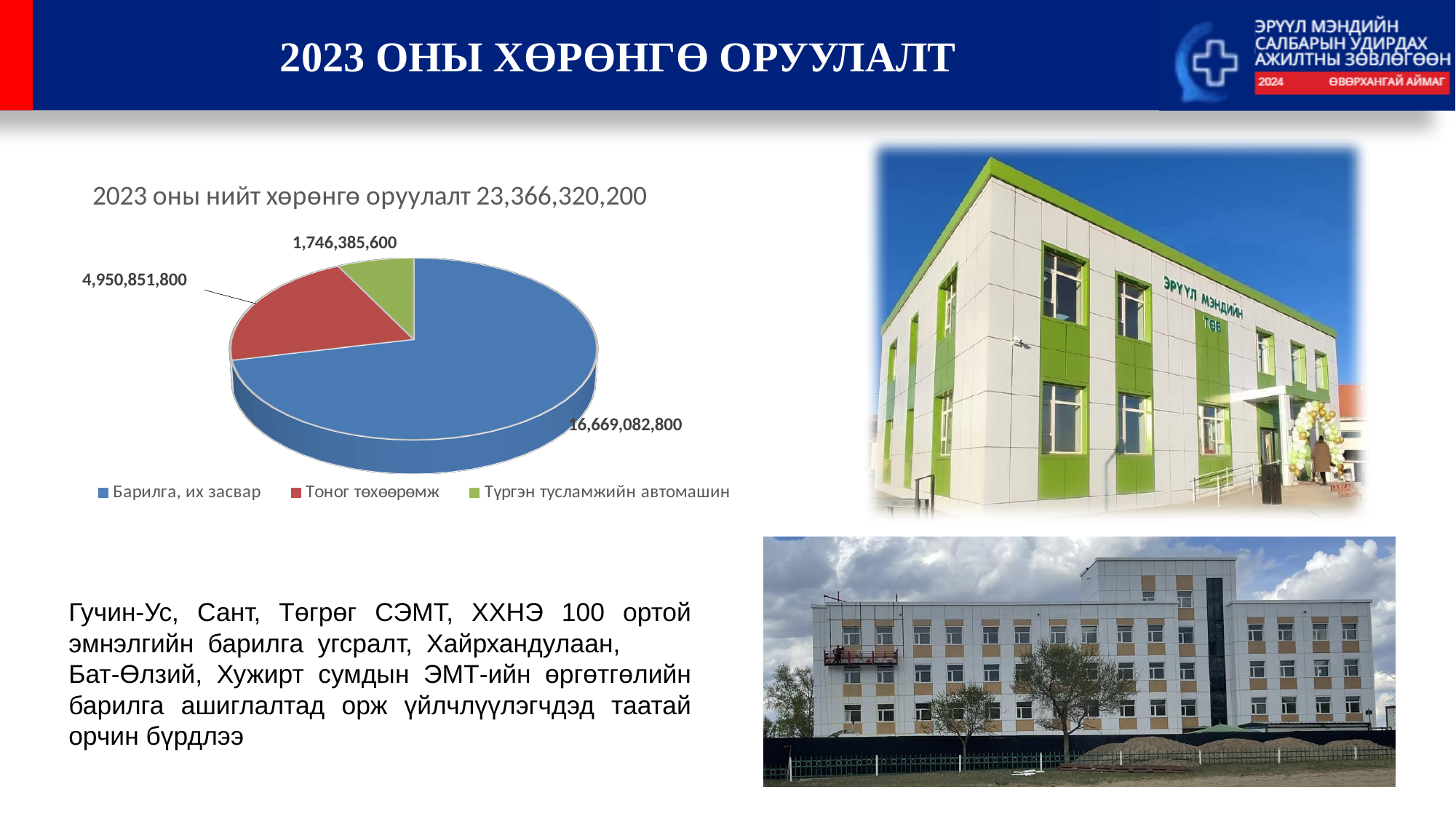
What is the value for Тоног төхөөрөмж in the pie chart? 4,950,851,800 What kind of chart is shown on the slide? Pie chart What is the difference between the values for Барилга, их засвар and Тоног төхөөрөмж in the pie chart? 11,718,231,000 Which is larger in the pie chart: Тоног төхөөрөмж or Түргэн тусламжийн автомашин? Тоног төхөөрөмж Which category has the largest slice in the pie chart? Барилга, их засвар How many slices does the pie chart have? 3 How many entries does the legend of the pie chart list? 3 What colour is the slice for Тоног төхөөрөмж in the pie chart? Red What is the value for Түргэн тусламжийн автомашин in the pie chart? 1,746,385,600 Which category has the smallest slice in the pie chart? Түргэн тусламжийн автомашин What is the title of the pie chart? 2023 оны нийт хөрөнгө оруулалт 23,366,320,200 What is the value for Барилга, их засвар in the pie chart? 16,669,082,800